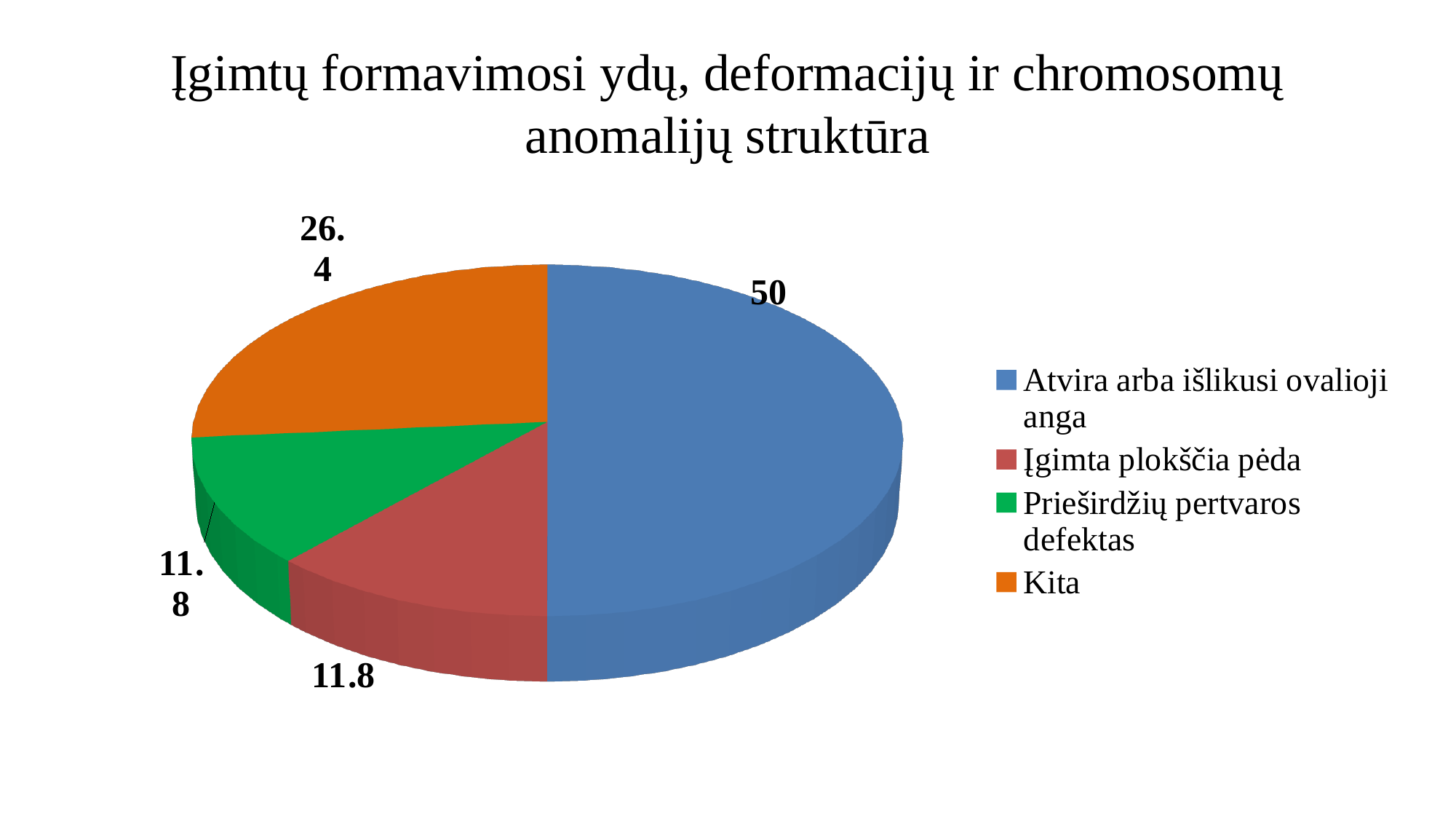
What is the value shown for the 'Įgimta plokščia pėda' slice? 11.8 What is the difference between the values for 'Kita' and 'Įgimta plokščia pėda'? 14.6 How many slices does the pie chart have? 4 What kind of chart is shown on the slide? Pie chart What share of the whole pie does the 'Kita' slice represent? 26.4% What is the value shown for the 'Kita' slice? 26.4 What is the difference between the values for 'Atvira arba išlikusi ovalioji anga' and 'Kita'? 23.6 Which is larger, the value for 'Kita' or the value for 'Įgimta plokščia pėda'? Kita What colour is the 'Kita' slice in the pie chart? Orange Which category has the largest slice of the pie? Atvira arba išlikusi ovalioji anga What is the value shown for the 'Atvira arba išlikusi ovalioji anga' slice? 50 What is the value shown for the 'Prieširdžių pertvaros defektas' slice? 11.8